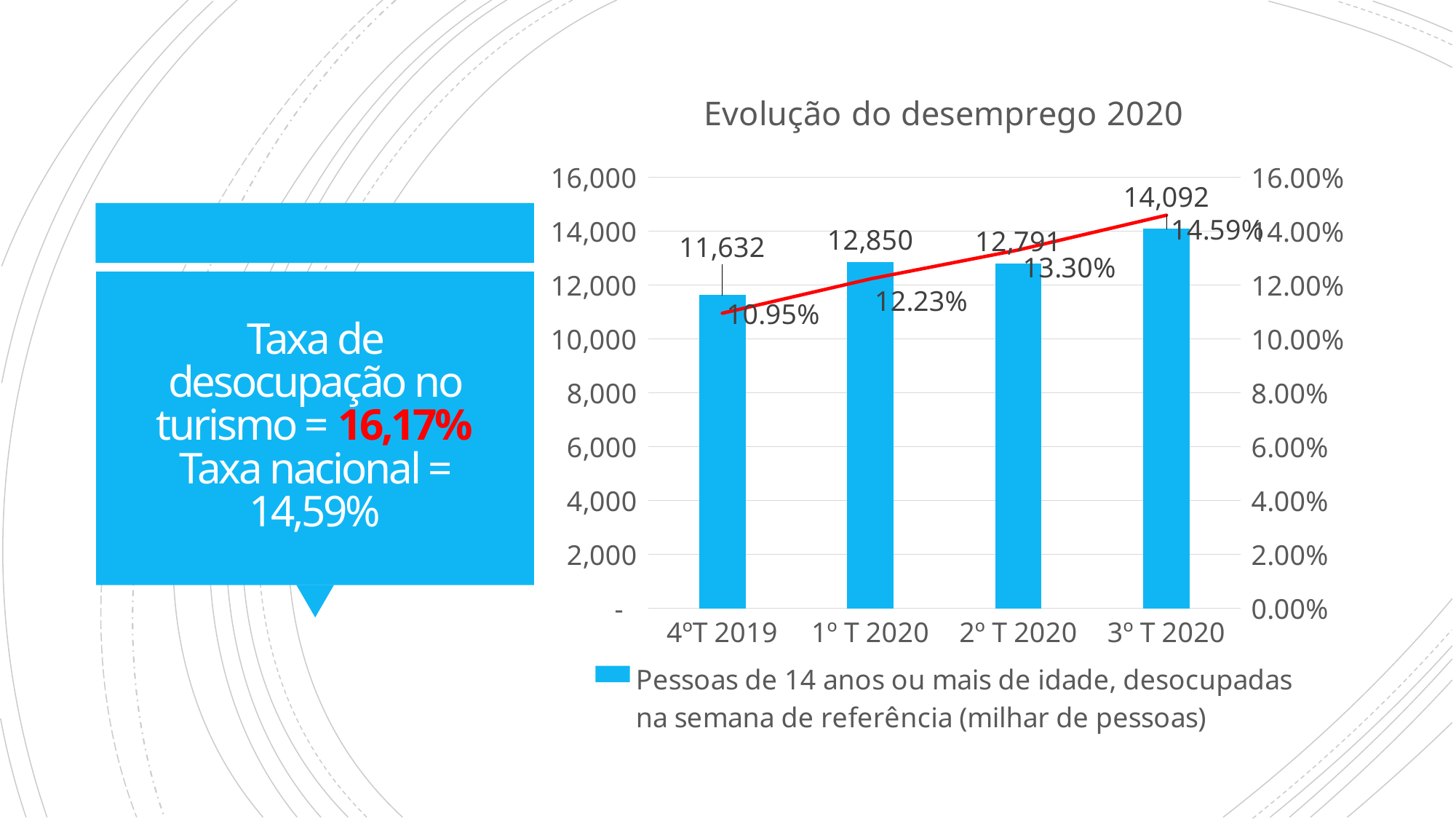
Which is larger, the bar value for 1º T 2020 or for 2º T 2020? 1º T 2020 What percentage is shown on the line for 2º T 2020? 13.30% What is the title of the chart? Evolução do desemprego 2020 What is the value of the bar for 4ºT 2019? 11,632 What is the difference between the bar values for 3º T 2020 and 4ºT 2019? 2,460 How many quarters are shown on the x axis? 4 What percentage is shown on the line for 4ºT 2019? 10.95% What is the value of the bar for 3º T 2020? 14,092 Which quarter has the lowest bar value? 4ºT 2019 Which quarter has the highest bar value? 3º T 2020 Do the percentage values on the line rise or fall from 4ºT 2019 to 3º T 2020? rise What is the value of the bar for 1º T 2020? 12,850